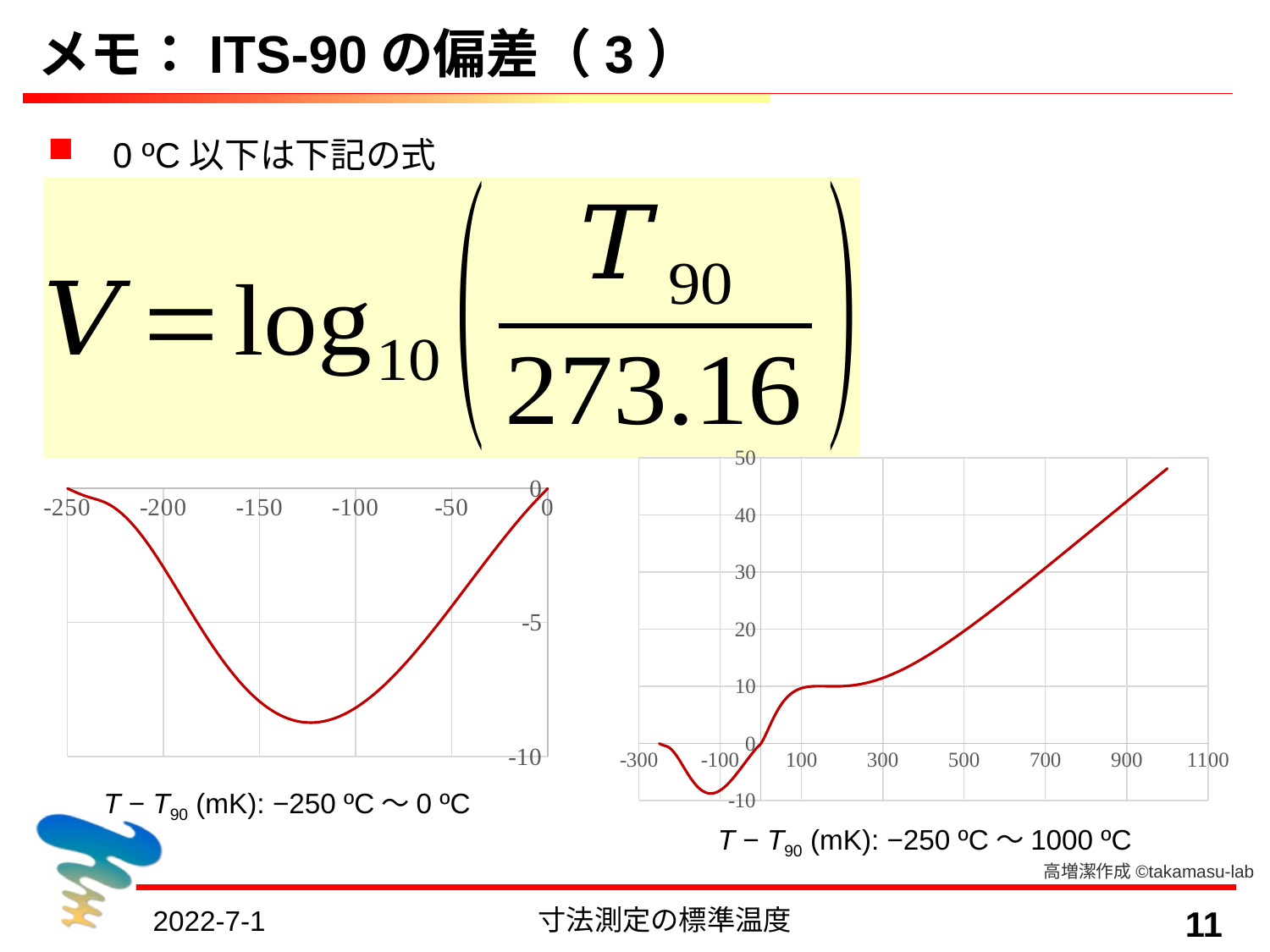
In the right chart (−250 ºC ～ 1000 ºC), is the value at x = −100 greater or less than 0? less In the left chart (−250 ºC ～ 0 ºC), does the curve rise or fall as x goes from −250 to −150? fall In the left chart (−250 ºC ～ 0 ºC), does the curve rise or fall as x goes from −100 to 0? rise In the right chart (−250 ºC ～ 1000 ºC), is the value at x = 1000 greater or less than 40? greater What kind of chart is the left chart (−250 ºC ～ 0 ºC)? line chart How many charts are shown on the slide? 2 In the right chart (−250 ºC ～ 1000 ºC), does the curve rise or fall as x goes from 300 to 1000? rise What kind of chart is the right chart (−250 ºC ～ 1000 ºC)? line chart In the left chart (−250 ºC ～ 0 ºC), is the value at x = −100 greater or less than −5? less What is the highest value shown on the y axis of the right chart (−250 ºC ～ 1000 ºC)? 50